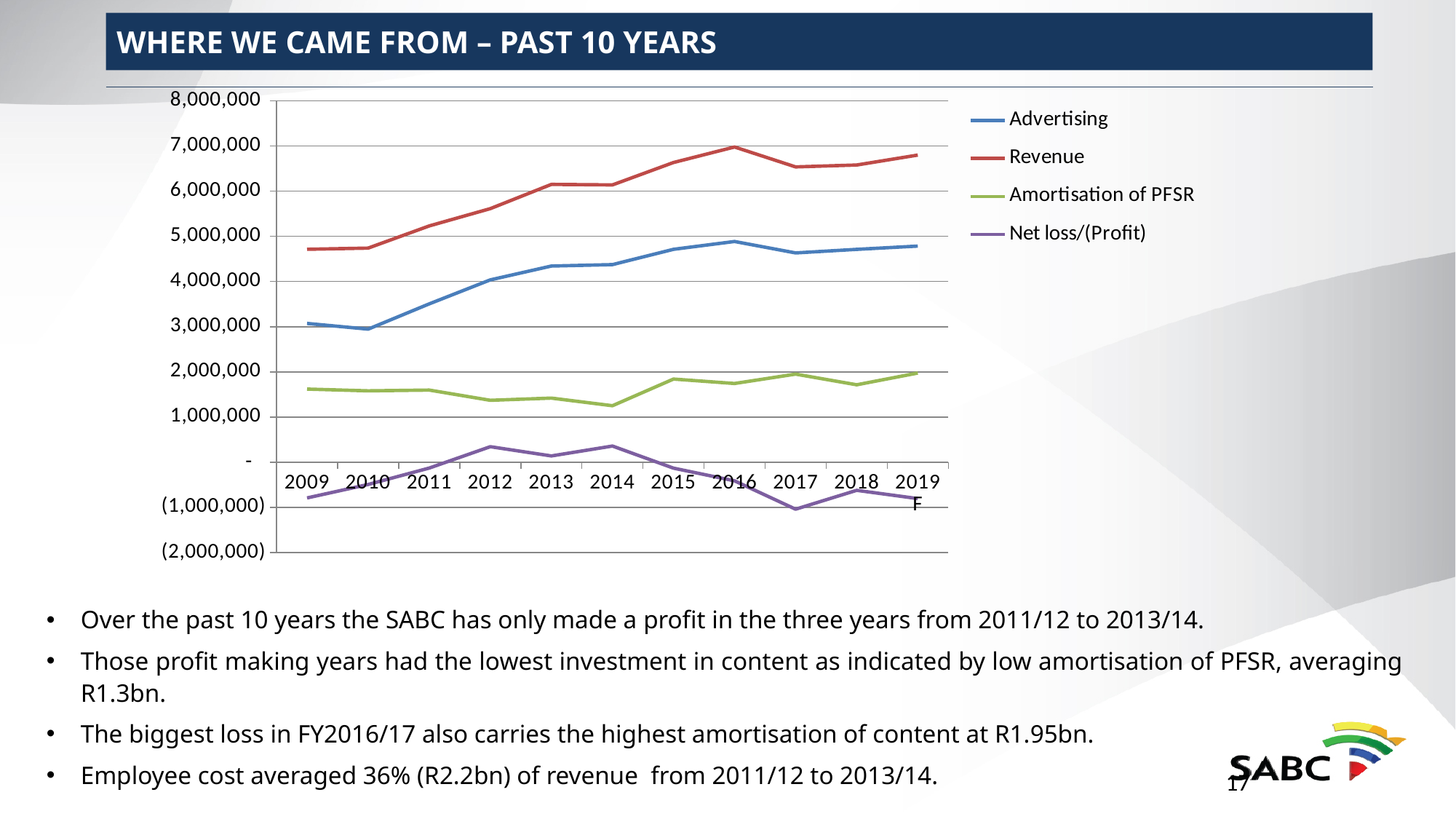
How many series does the chart legend list? 4 What kind of chart is shown on the slide? Line chart In which year does the Revenue series reach its highest value? 2016 Is the Revenue value for 2015 greater or less than 6,000,000? greater Does the Revenue series rise or fall from 2009 to 2016? Rise Is the Revenue value for 2009 greater or less than 5,000,000? less How many years are plotted along the x axis of the chart? 11 Which colour is used for the Amortisation of PFSR line in the chart? Green In which year is the Advertising series at its lowest value? 2010 In which year is the Net loss/(Profit) series at its lowest value? 2017 Which series has the larger value in 2019, Revenue or Advertising? Revenue Is the Advertising value for 2013 greater or less than 4,000,000? greater